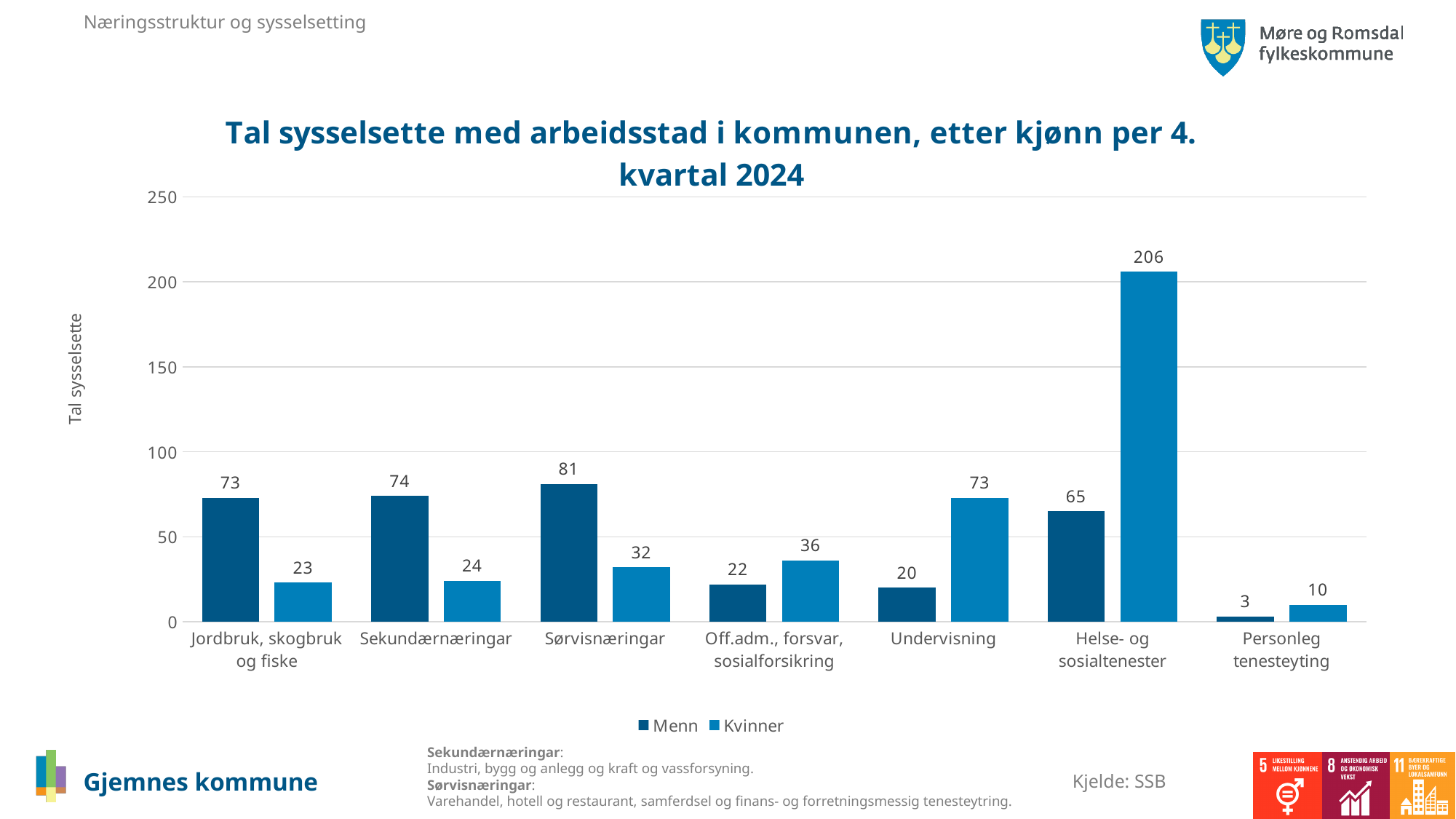
What is the difference between Kvinner and Menn in Helse- og sosialtenester? 141 Which category has the highest value for Kvinner? Helse- og sosialtenester How many categories are shown on the x axis? 7 How many series does the legend list? 2 What is the label of the y axis? Tal sysselsette What kind of chart is shown on the slide? Bar chart Which is larger in Off.adm., forsvar, sosialforsikring: Menn or Kvinner? Kvinner What is the value for Kvinner in Undervisning? 73 What is the value for Kvinner in Helse- og sosialtenester? 206 Is the value for Kvinner in Helse- og sosialtenester greater or less than 200? greater Which category has the lowest value for Menn? Personleg tenesteyting What is the value for Menn in Sørvisnæringar? 81